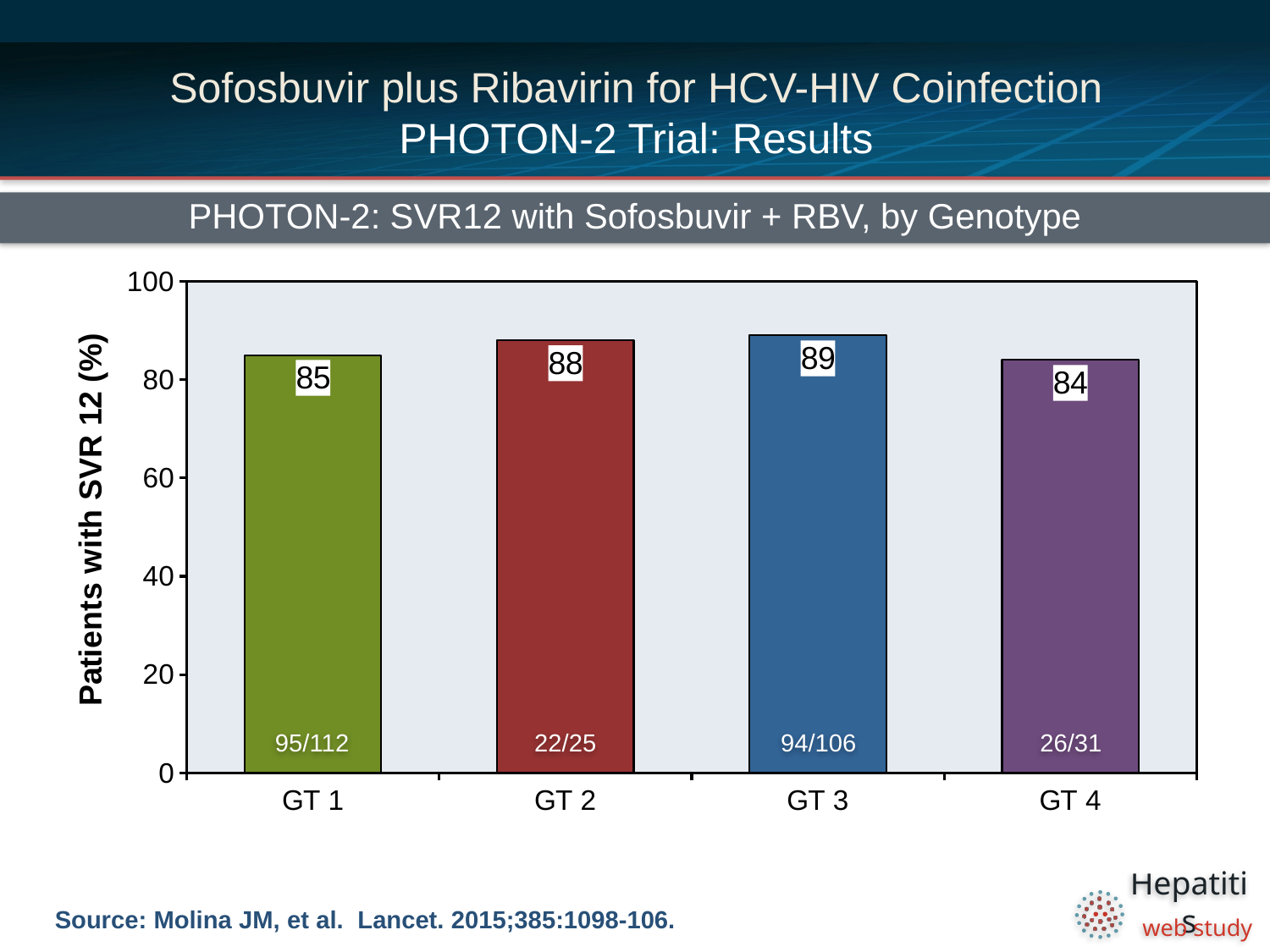
What is the difference in SVR12 rate between GT 3 and GT 4? 5 Which has a higher SVR12 rate, GT 2 or GT 1? GT 2 What is the label of the y axis? Patients with SVR 12 (%) Is the SVR12 rate for GT 4 greater or less than 60? greater Which genotype has the highest SVR12 rate? GT 3 What fraction of patients is shown inside the GT 2 bar? 22/25 How many genotype categories are shown on the x axis? 4 What fraction of patients is shown inside the GT 3 bar? 94/106 Which genotype has the lowest SVR12 rate? GT 4 What is the SVR12 rate (%) for GT 4? 84 What kind of chart is shown on the slide? Bar chart What is the SVR12 rate (%) for GT 1? 85